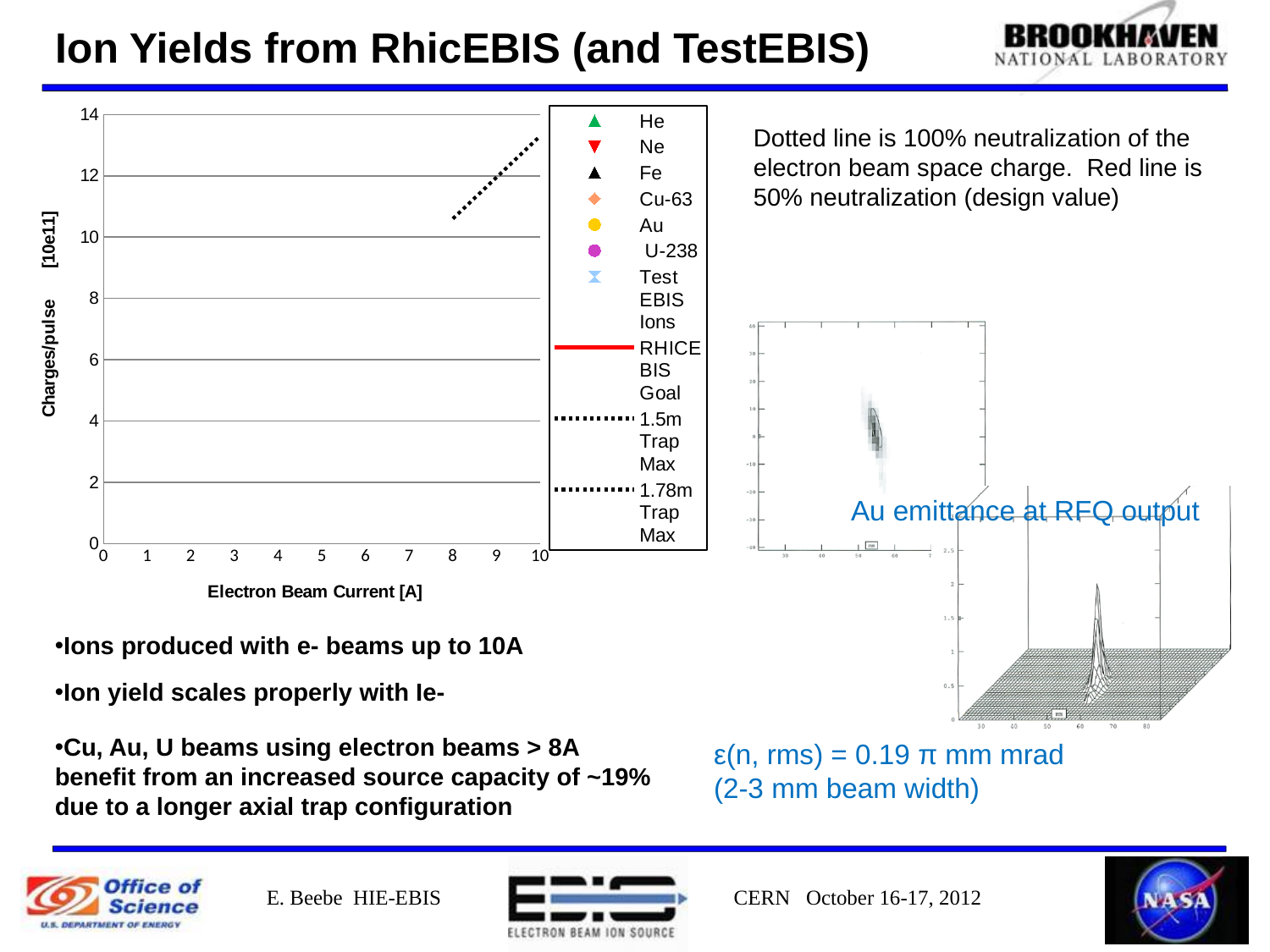
Is the value of the dotted line at an Electron Beam Current of 10 A greater or less than 12? greater Is the value of the dotted line at an Electron Beam Current of 9 A greater or less than 10? greater How many tick labels are shown on the x axis of the chart? 11 What colour is the line for the RHICEBIS Goal series in the chart legend? red Is the value of the dotted line at an Electron Beam Current of 9 A greater or less than 14? less What is the label of the x axis of the chart? Electron Beam Current [A] How many series does the legend of the chart list? 10 Does the dotted line plotted on the chart rise or fall as Electron Beam Current increases? rises